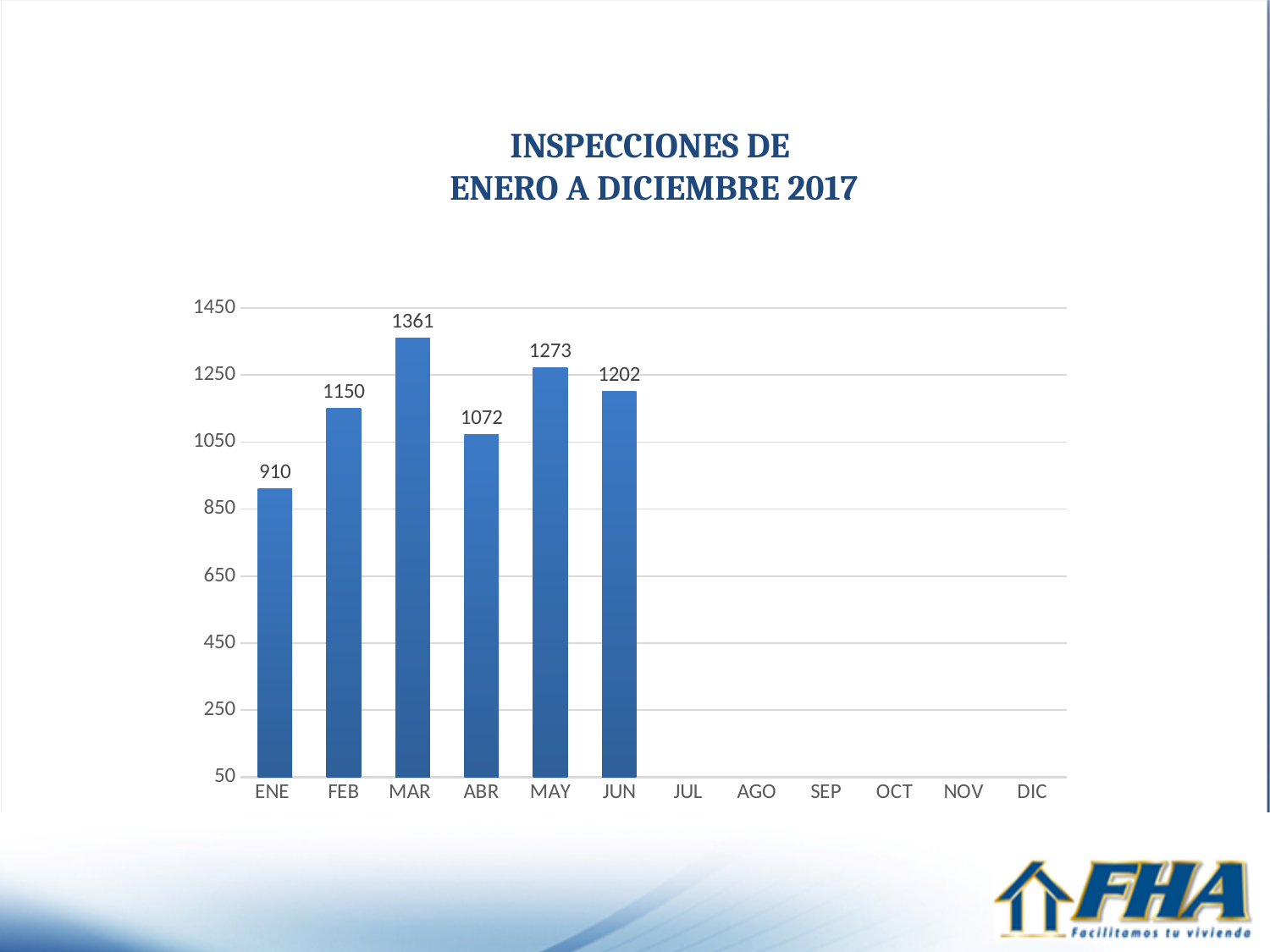
What is the difference between the values for FEB and ENE? 240 What is the difference between the values for MAR and ABR? 289 What is the title of the chart? INSPECCIONES DE ENERO A DICIEMBRE 2017 How many months have a bar plotted on the chart? 6 Is the value for ABR greater or less than 1050? greater What is the value for MAR? 1361 Which is larger, the value for MAY or the value for JUN? MAY What is the value for ENE? 910 Which month has the highest value? MAR What kind of chart is shown on the slide? bar chart What is the value for JUN? 1202 Among the months with plotted bars, which has the lowest value? ENE